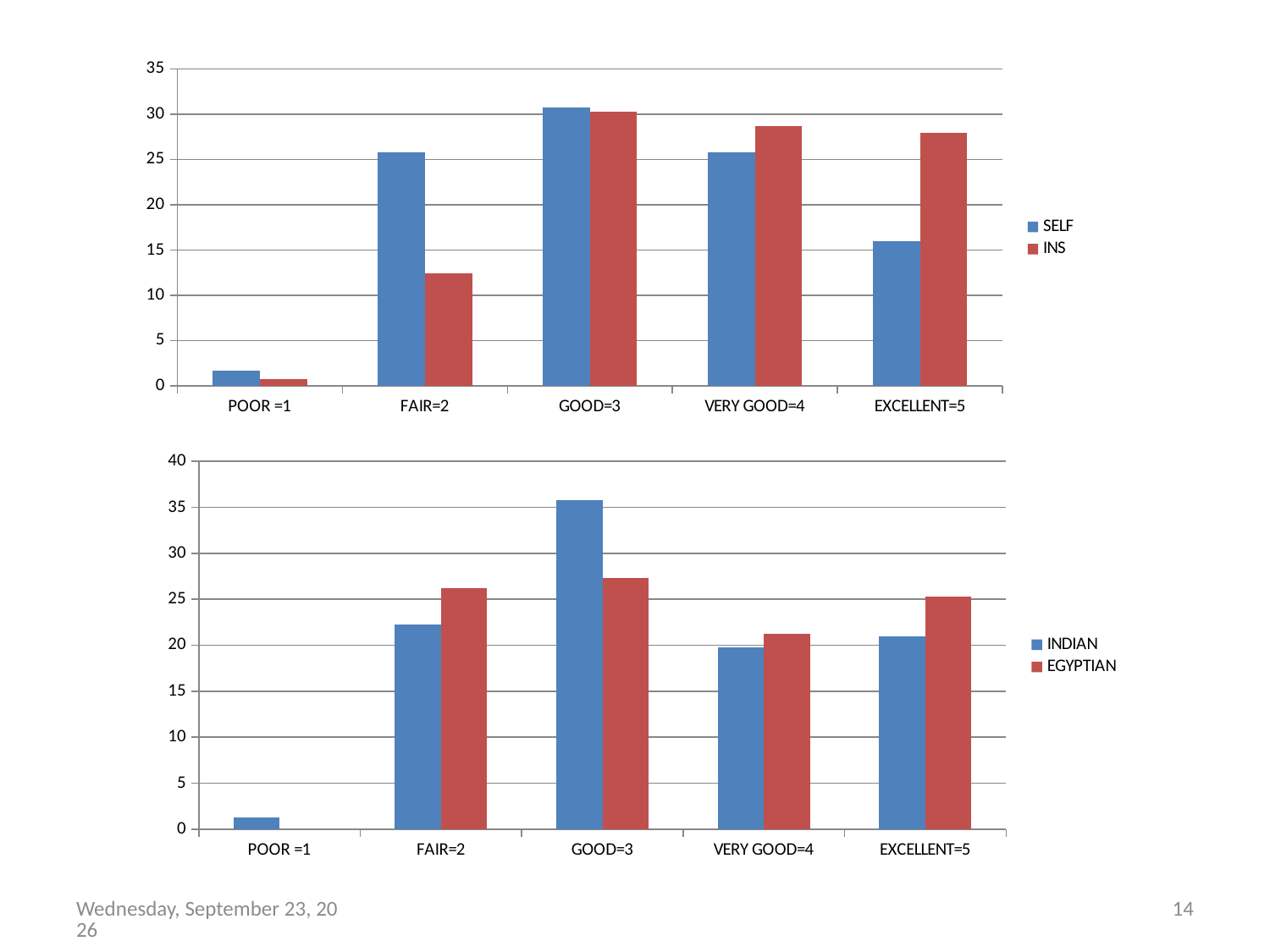
In the top chart, is the INS value for FAIR=2 greater or less than 15? less In the bottom chart, is the INDIAN value for GOOD=3 greater or less than 30? greater In the top chart, for FAIR=2, which series is larger, SELF or INS? SELF In the top chart, which category has the lowest INS value? POOR =1 How many series does the legend of the top chart list? 2 In the top chart, which category has the highest SELF value? GOOD=3 In the bottom chart, for GOOD=3, which series is larger, INDIAN or EGYPTIAN? INDIAN What are the two legend entries of the bottom chart? INDIAN and EGYPTIAN What kind of chart is the top chart on the slide? bar chart In the top chart, for EXCELLENT=5, which series is larger, SELF or INS? INS In the bottom chart, which category has the highest INDIAN value? GOOD=3 How many categories are shown on the x axis of the bottom chart? 5